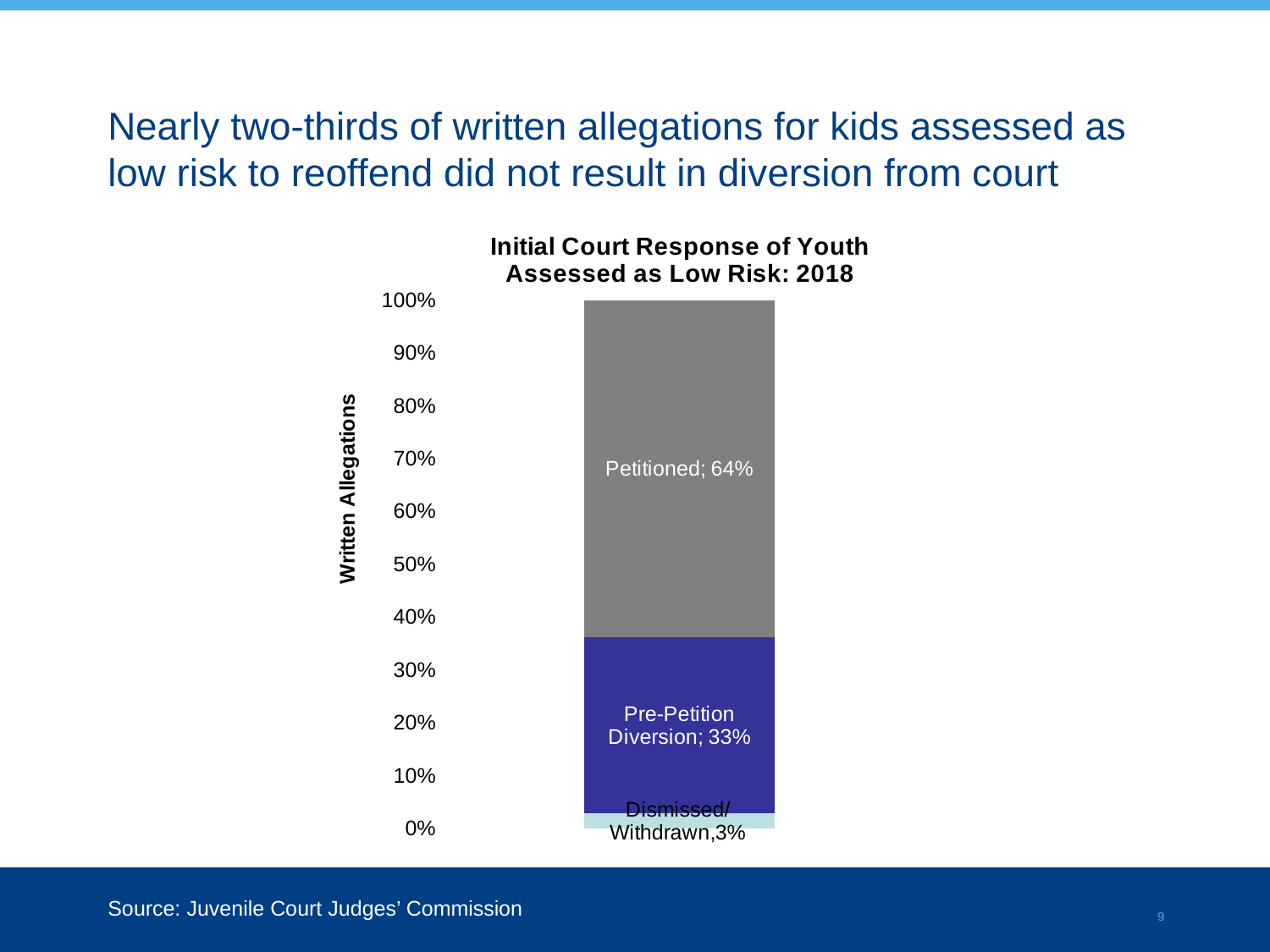
How many segments make up the stacked bar? 3 Which segment of the stacked bar is the largest? Petitioned Which segment of the stacked bar is the smallest? Dismissed/Withdrawn What is the difference between the Petitioned share and the Pre-Petition Diversion share? 31% Is the Petitioned share greater or less than 50%? greater What is the label on the vertical axis of the chart? Written Allegations What is the title of the chart? Initial Court Response of Youth Assessed as Low Risk: 2018 What percentage of written allegations went to Pre-Petition Diversion? 33% What type of chart is shown on the slide? Stacked bar chart Which is larger, the Pre-Petition Diversion share or the Dismissed/Withdrawn share? Pre-Petition Diversion What percentage of written allegations were Dismissed/Withdrawn? 3% What percentage of written allegations were Petitioned? 64%